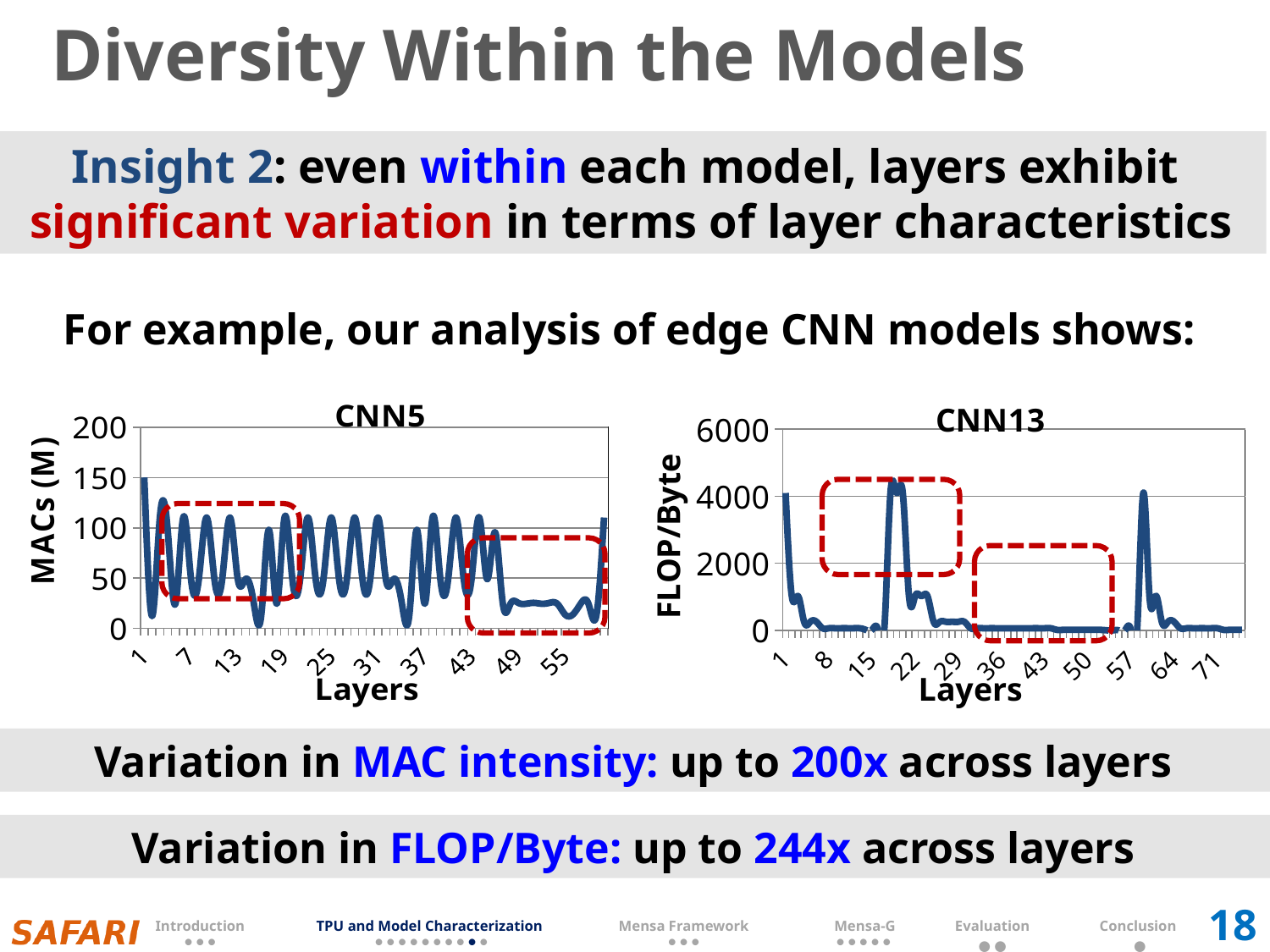
How many data series are plotted in the CNN5 chart? 1 In the CNN13 chart, is the value for layer 43 greater or less than 2000? less What is the y-axis label of the CNN13 chart? FLOP/Byte In the CNN13 chart, is the value for layer 8 greater or less than 2000? less What is the y-axis label of the CNN5 chart? MACs (M) In the CNN13 chart, is the value at layer 1 larger or smaller than the value at layer 36? larger What kind of chart is the CNN13 chart? line chart In the CNN5 chart, is the value for layer 49 greater or less than 50? less In the CNN5 chart, is the value at layer 1 larger or smaller than the value at layer 49? larger What kind of chart is the CNN5 chart? line chart